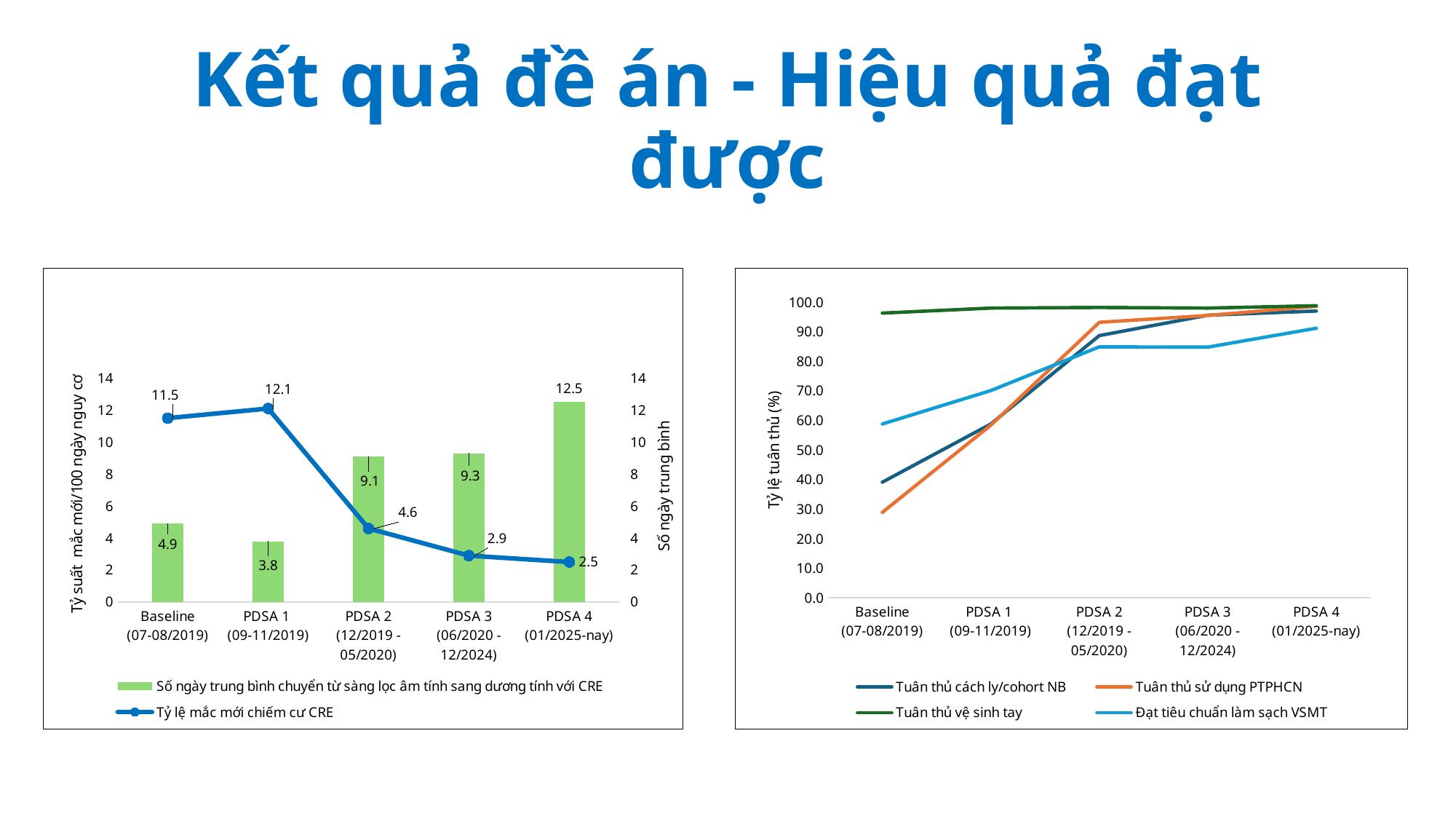
On the left chart, what is the value of the line 'Tỷ lệ mắc mới chiếm cư CRE' at PDSA 2 (12/2019 - 05/2020)? 4.6 On the left chart, how many categories are shown on the x axis? 5 On the left chart, which is larger: the bar value at PDSA 2 or the bar value at PDSA 3? PDSA 3 On the left chart, does the line 'Tỷ lệ mắc mới chiếm cư CRE' rise or fall from PDSA 1 to PDSA 4? fall On the left chart, what is the difference between the line values at PDSA 1 and PDSA 2? 7.5 How many series does the legend of the right chart list? 4 On the right chart, is the value for 'Tuân thủ sử dụng PTPHCN' at Baseline greater or less than 40.0? less On the left chart, at which category is the line 'Tỷ lệ mắc mới chiếm cư CRE' lowest? PDSA 4 (01/2025-nay) What kind of chart is the right chart? line chart On the left chart, what is the value of the bar for PDSA 4 (01/2025-nay)? 12.5 On the right chart, which series has the highest value at Baseline (07-08/2019)? Tuân thủ vệ sinh tay On the left chart, which category has the highest bar value? PDSA 4 (01/2025-nay)